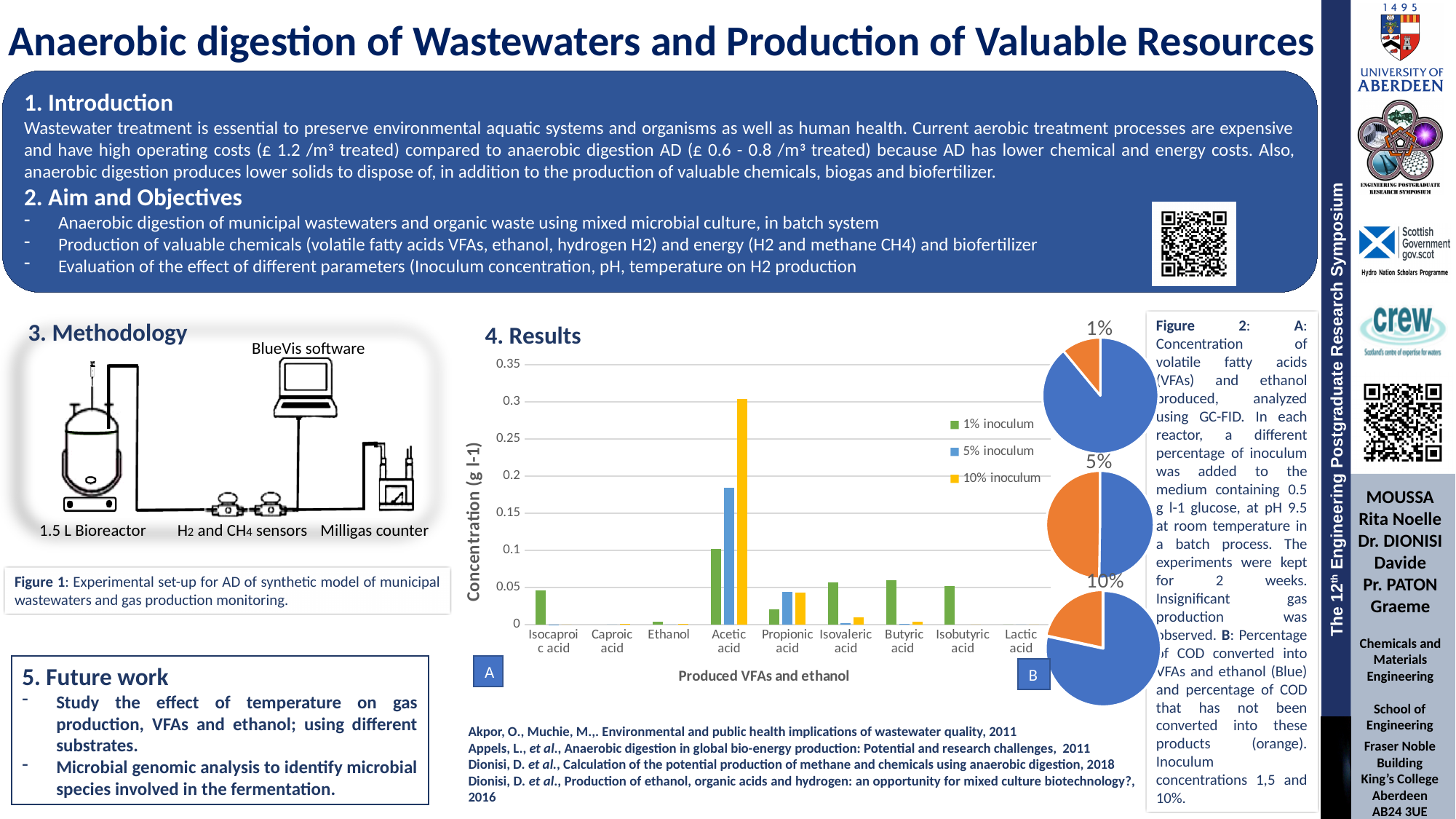
In the bar chart (Figure 2A), how many series does the legend list? 3 In the bar chart (Figure 2A), which is larger for Acetic acid: the 5% inoculum value or the 10% inoculum value? 10% inoculum In the pie chart labelled 1% (Figure 2B), which slice is larger, the blue or the orange? blue What kind of chart is Figure 2A, the chart titled 'Produced VFAs and ethanol'? bar chart In the bar chart (Figure 2A), how many categories are shown on the x axis? 9 In the bar chart (Figure 2A), which category has the tallest bar overall? Acetic acid In the bar chart (Figure 2A), is the value for Acetic acid with 5% inoculum greater or less than 0.15? greater In the bar chart (Figure 2A), which colour represents the 10% inoculum series? yellow In the bar chart (Figure 2A), what is the label of the y axis? Concentration (g l-1) In the bar chart (Figure 2A), is the value for Acetic acid with 10% inoculum greater or less than 0.25? greater In the bar chart (Figure 2A), is the value for Butyric acid with 1% inoculum greater or less than 0.1? less In the bar chart (Figure 2A), which series has the highest value for Acetic acid? 10% inoculum